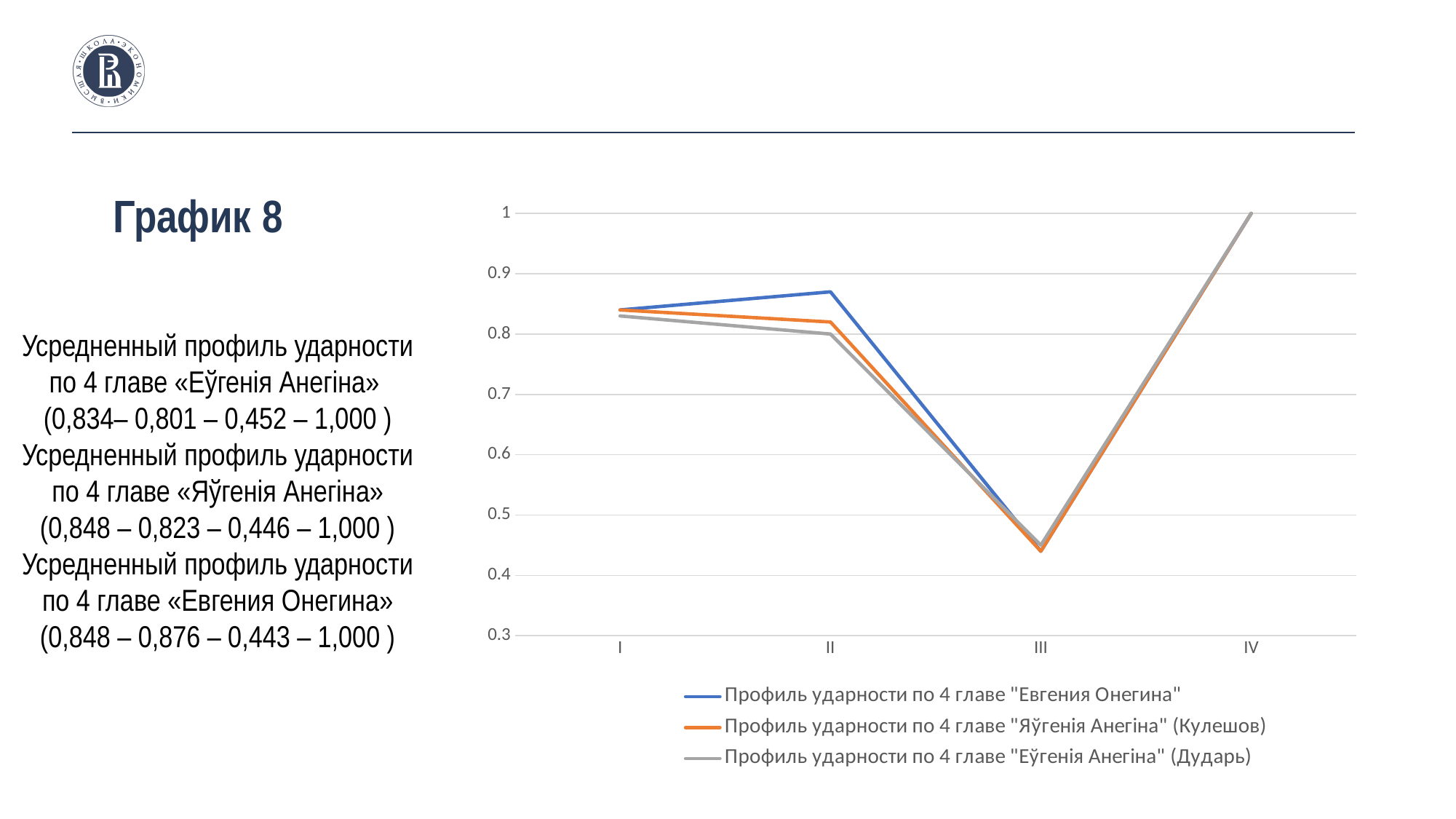
What is the value of the series Профиль ударности по 4 главе "Евгения Онегина" at IV? 1 At which x-axis point is the series Профиль ударности по 4 главе "Яўгенія Анегіна" (Кулешов) lowest? III At which x-axis point is the series Профиль ударности по 4 главе "Евгения Онегина" highest? IV At II, which series has the larger value: Профиль ударности по 4 главе "Евгения Онегина" or Профиль ударности по 4 главе "Еўгенія Анегіна" (Дударь)? Профиль ударности по 4 главе "Евгения Онегина" Is the value of the series Профиль ударности по 4 главе "Еўгенія Анегіна" (Дударь) at III greater or less than 0.5? less What colour is the line for the series Профиль ударности по 4 главе "Евгения Онегина"? blue Do the values of the series Профиль ударности по 4 главе "Яўгенія Анегіна" (Кулешов) rise or fall from II to III? fall Is the value of the series Профиль ударности по 4 главе "Евгения Онегина" at II greater or less than 0.8? greater How many series does the legend list? 3 What is the value of the series Профиль ударности по 4 главе "Еўгенія Анегіна" (Дударь) at IV? 1 What kind of chart is shown on the slide? line chart How many points are there along the x axis? 4